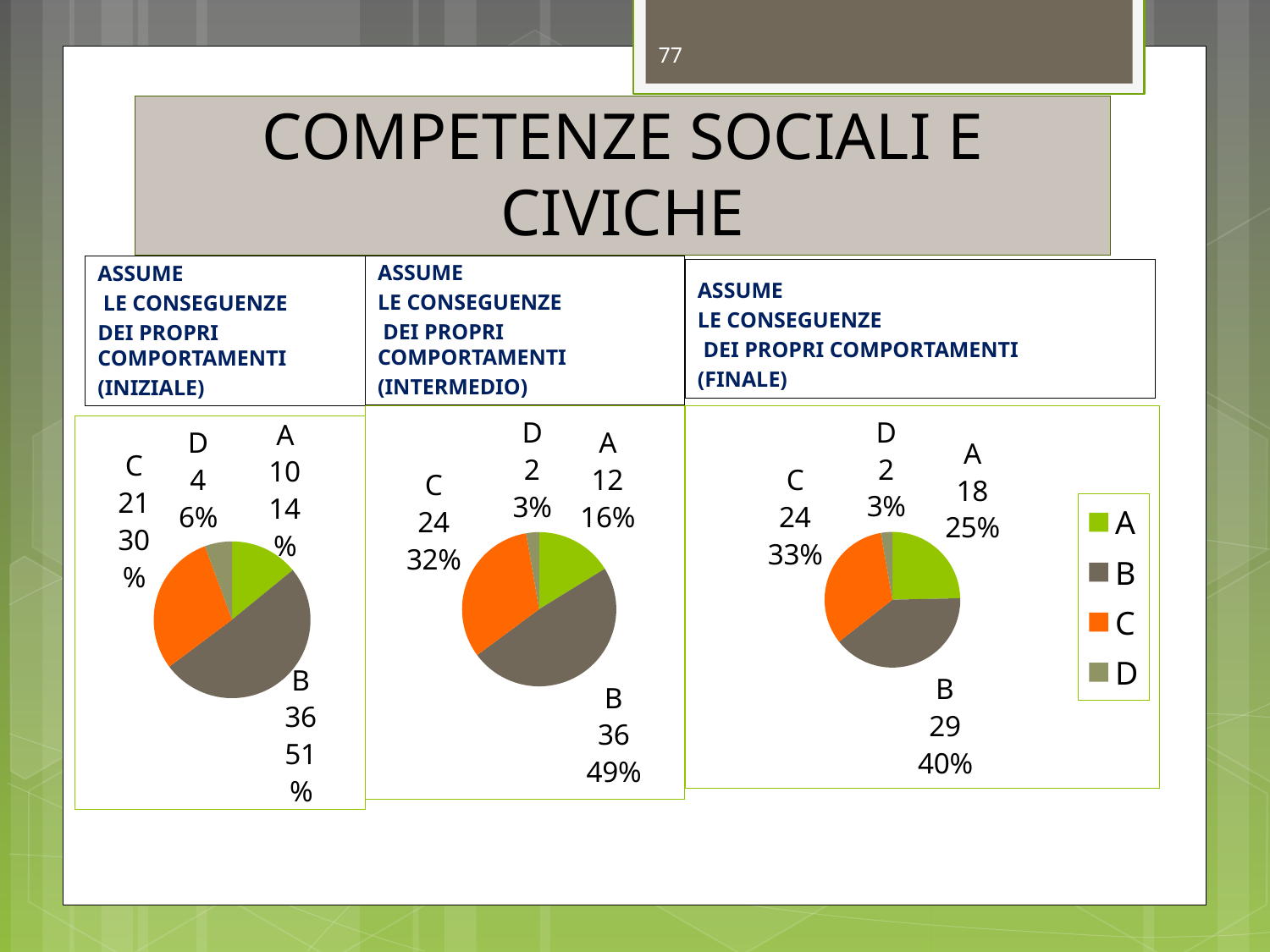
In the FINALE pie chart, which is larger, the share for A or the share for C? C In the INIZIALE pie chart, what percentage is shown for category B? 51% In the FINALE pie chart, which category has the largest share? B In the INIZIALE pie chart, what count is shown for category C? 21 What type of chart is used for the INTERMEDIO data? Pie chart How many entries does the legend next to the FINALE chart list? 4 How many categories does the FINALE pie chart show? 4 In the legend next to the FINALE chart, which colour represents category C? Orange In the INIZIALE pie chart, which category has the smallest share? D In the INTERMEDIO pie chart, what percentage is shown for category C? 32% In the FINALE pie chart, what count is shown for category A? 18 In the INTERMEDIO pie chart, what is the difference in count between category B and category A? 24